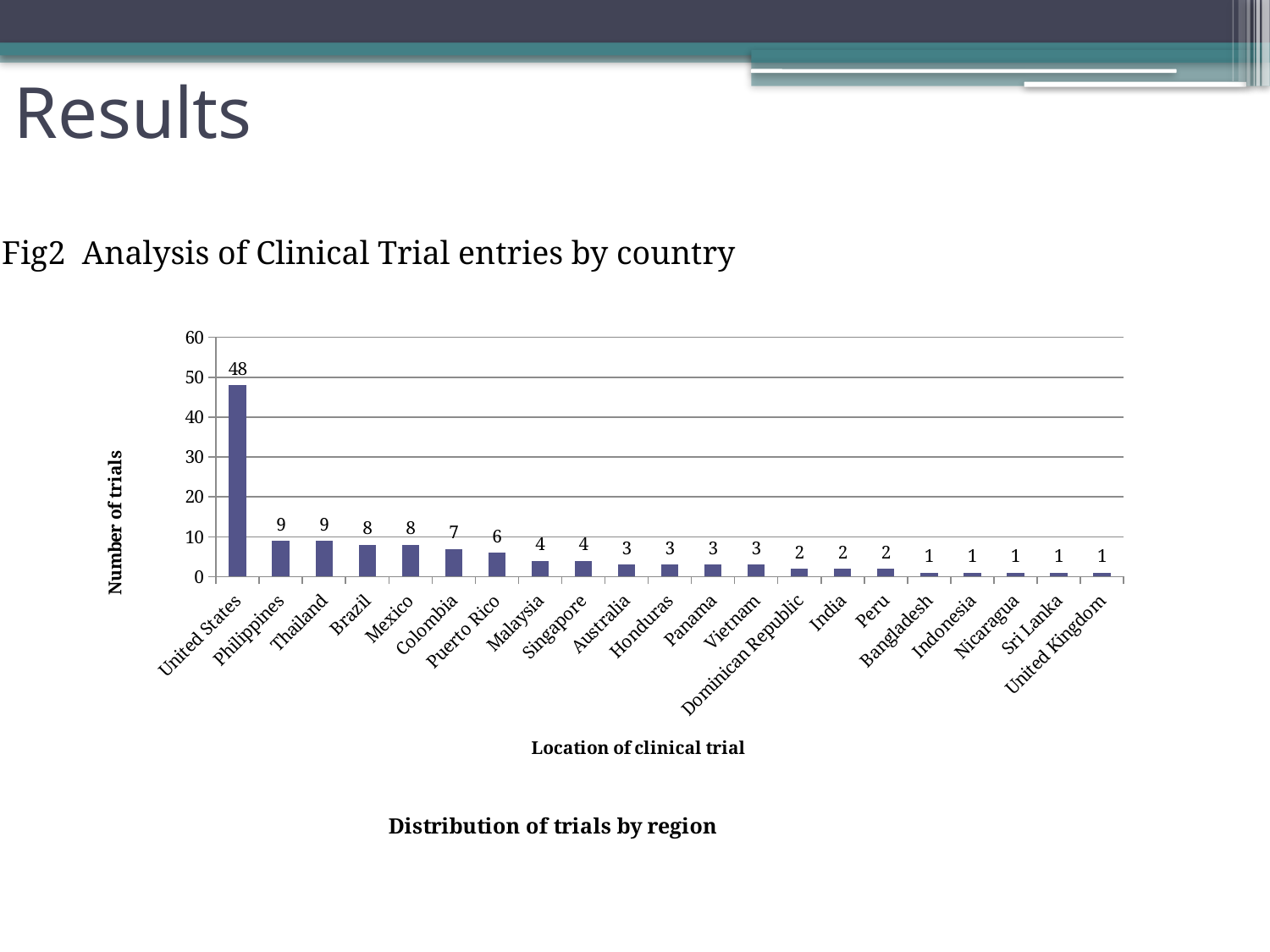
What kind of chart is shown on the slide? Bar chart How many countries are shown on the x axis? 21 What is the label of the y axis? Number of trials Is the value for the United States greater or less than 40? greater Which has more trials, Brazil or Malaysia? Brazil Which country has the highest number of trials? United States What is the number of trials for Colombia? 7 What is the difference in number of trials between Mexico and Puerto Rico? 2 What is the difference in number of trials between the United States and the Philippines? 39 What is the number of trials for Vietnam? 3 What is the number of trials for the United States? 48 Do the values rise or fall moving from left to right along the x axis? Fall